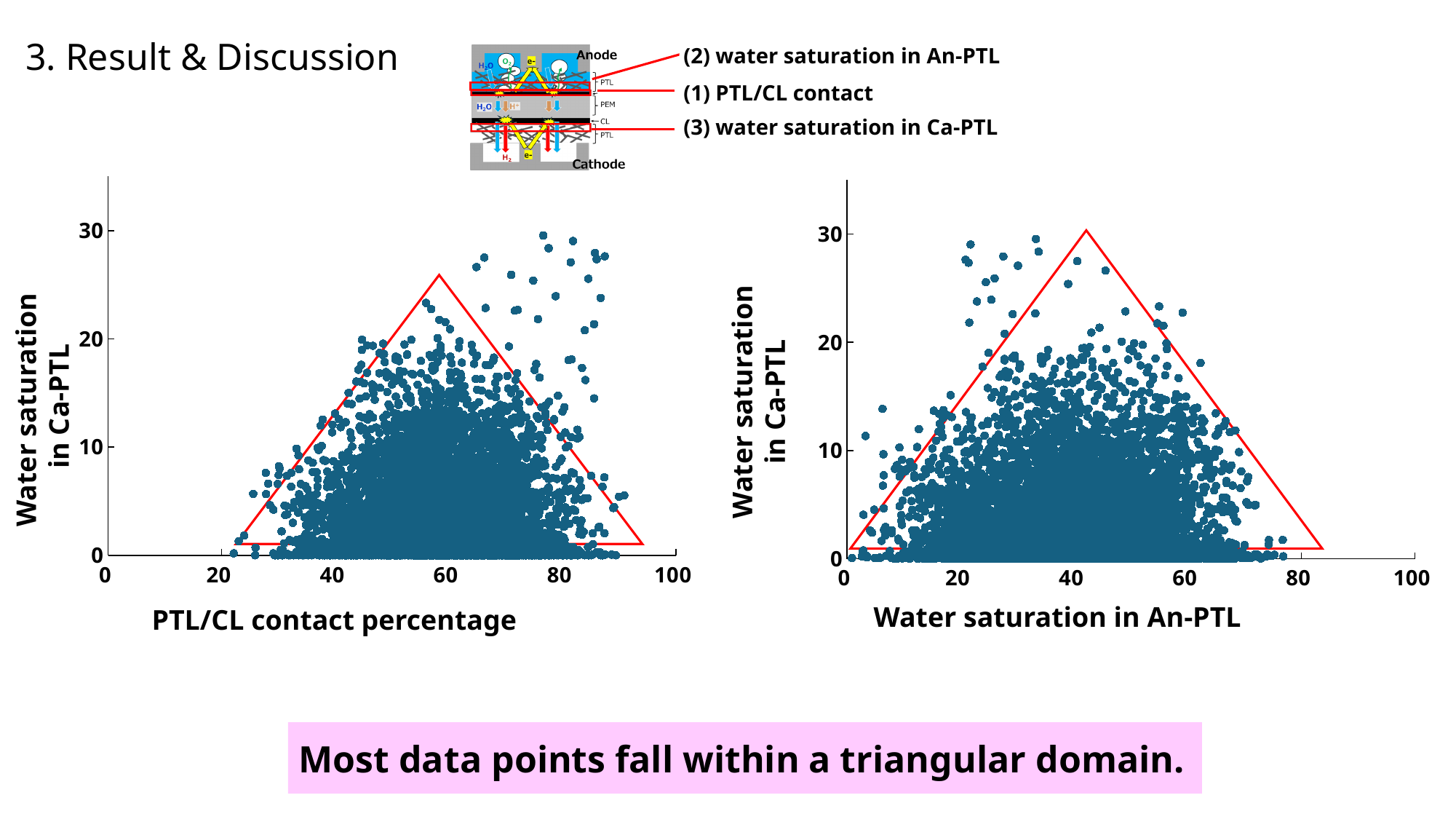
In the right chart, is the x position of the red triangle's peak greater or less than 60? less In the right chart, is the largest water saturation in An-PTL with a data point greater or less than 80? less In the right chart, is the peak of the red triangle greater or less than 20 on the y axis? greater What kind of chart is the right chart on the slide? scatter plot What kind of chart is the left chart on the slide? scatter plot What is the maximum value shown on the x axis of the left chart? 100 What is the x-axis label of the right chart? Water saturation in An-PTL What is the highest tick value shown on the y axis of the right chart? 30 What is the x-axis label of the left chart? PTL/CL contact percentage